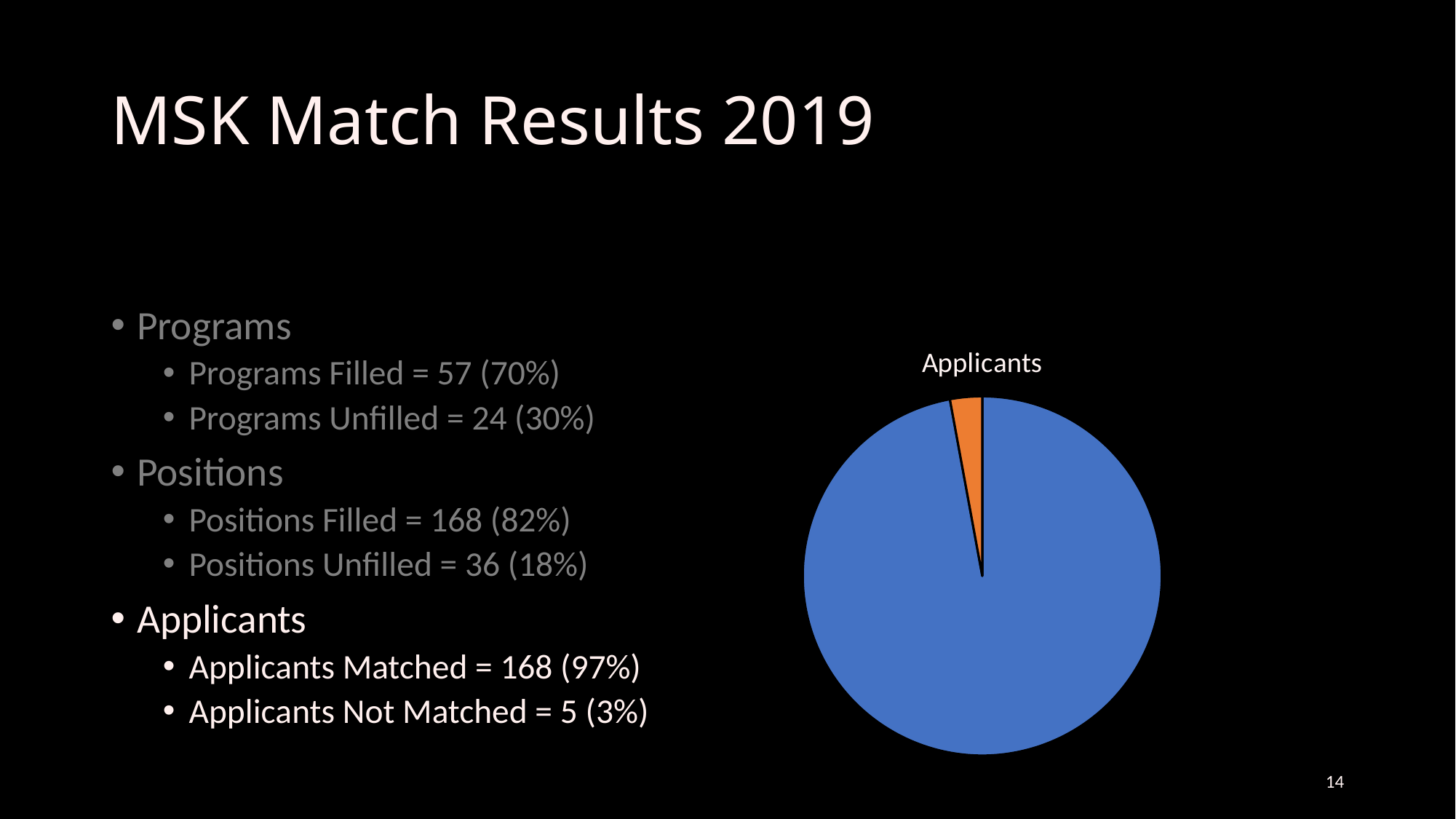
How many applicants were not matched, according to the slide? 5 Which colour slice is the largest in the Applicants pie chart? blue How many slices does the Applicants pie chart have? 2 What is the title of the pie chart? Applicants How many applicants were matched, according to the slide? 168 In the Applicants pie chart, is the blue slice larger or smaller than the orange slice? larger According to the slide, what share of applicants were not matched? 3% Which colour slice is the smallest in the Applicants pie chart? orange What kind of chart is shown on the slide? pie chart According to the slide, what share of applicants were matched? 97% Does the Applicants pie chart display a legend? No What is the total number of applicants represented in the Applicants pie chart (matched plus not matched)? 173